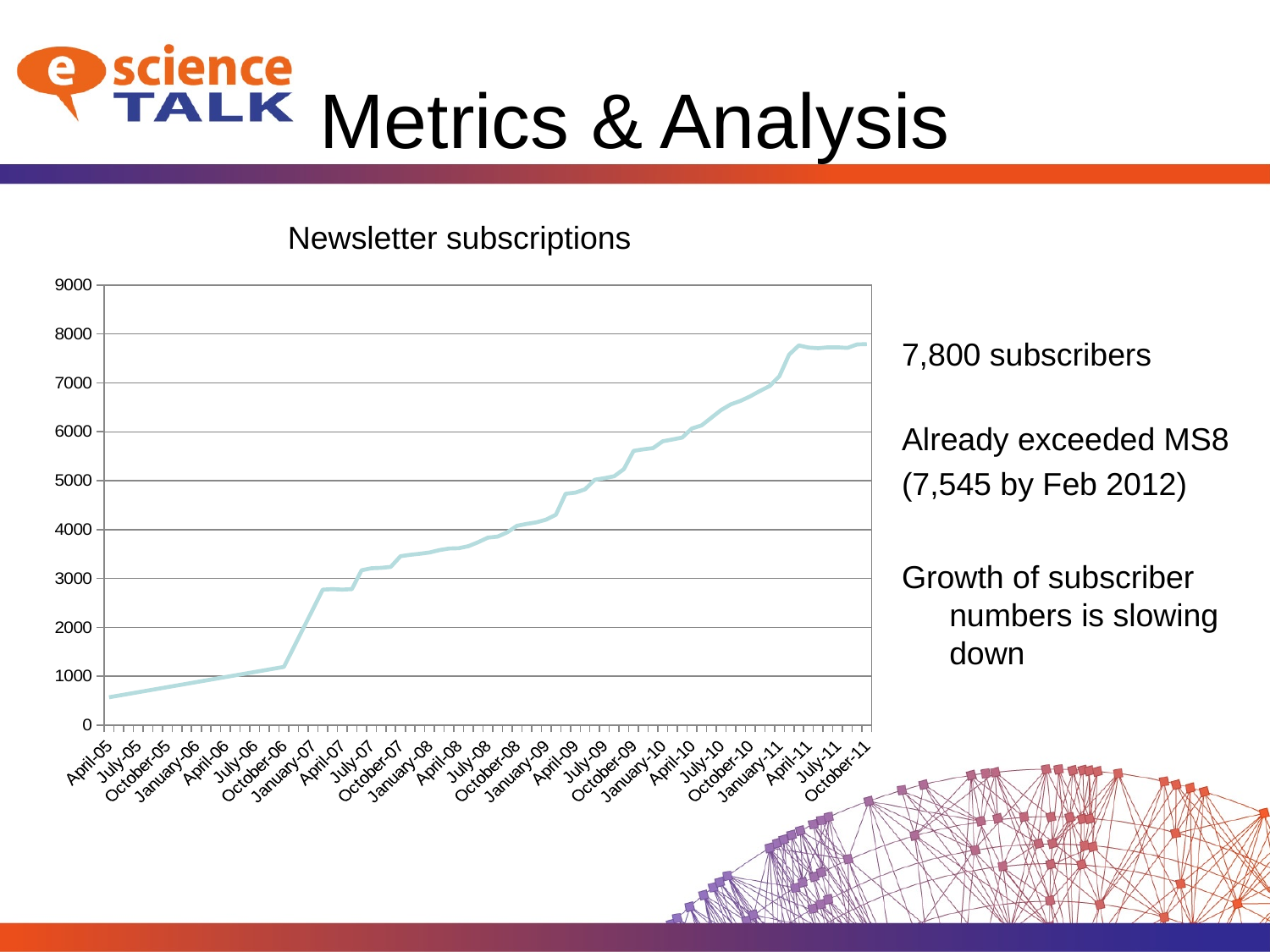
What is the title of the chart? Newsletter subscriptions Which x-axis label has the lowest newsletter subscription value? April-05 What kind of chart is shown on the slide? line chart Do the newsletter subscription values generally rise or fall from April-05 to October-11? rise Which x-axis label has the highest newsletter subscription value? October-11 Is the value for April-05 greater or less than 1000? less Is the value for July-08 greater or less than 4000? less Is the value for October-11 greater or less than 7000? greater Which is larger, the value for October-11 or the value for April-05? October-11 How many x-axis labels are shown on the chart? 27